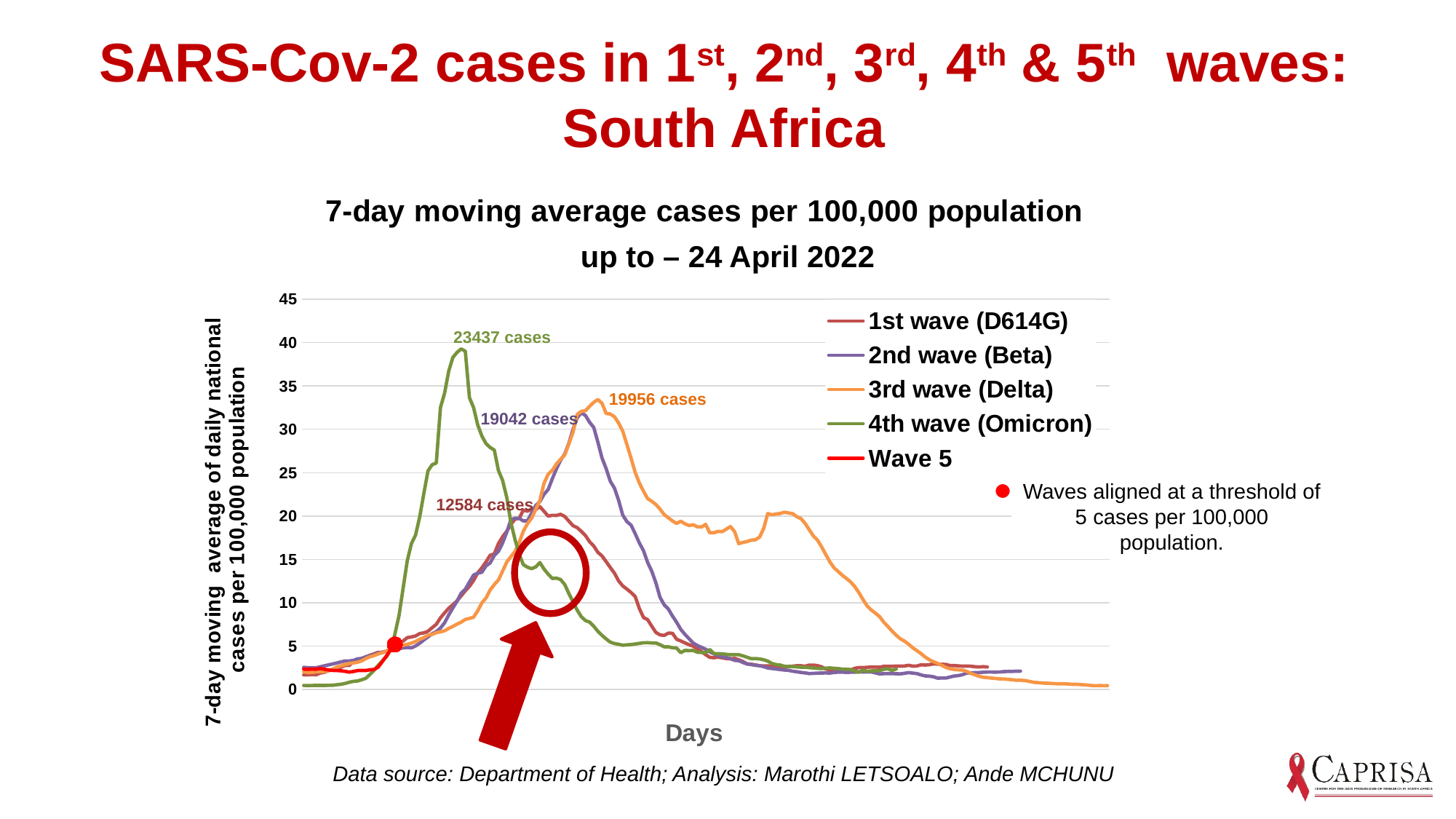
Among the four waves with annotated peak case counts, which wave has the lowest peak? 1st wave (D614G) How many series does the chart legend list? 5 Is the peak value of the 4th wave (Omicron) greater or less than 35 cases per 100,000? greater What peak case count is annotated for the 4th wave (Omicron)? 23437 cases Which has a higher peak, the 1st wave (D614G) or the 2nd wave (Beta)? 2nd wave (Beta) Which wave reaches the highest peak in the chart? 4th wave (Omicron) According to the note next to the red dot, at what threshold are the waves aligned? 5 cases per 100,000 population What peak case count is annotated for the 3rd wave (Delta)? 19956 cases Is the peak value of the 1st wave (D614G) greater or less than 25 cases per 100,000? less What is the difference between the annotated peak case counts of the 4th wave (Omicron) and the 3rd wave (Delta)? 3481 cases What type of chart is shown on the slide? line chart What peak case count is annotated for the 1st wave (D614G)? 12584 cases